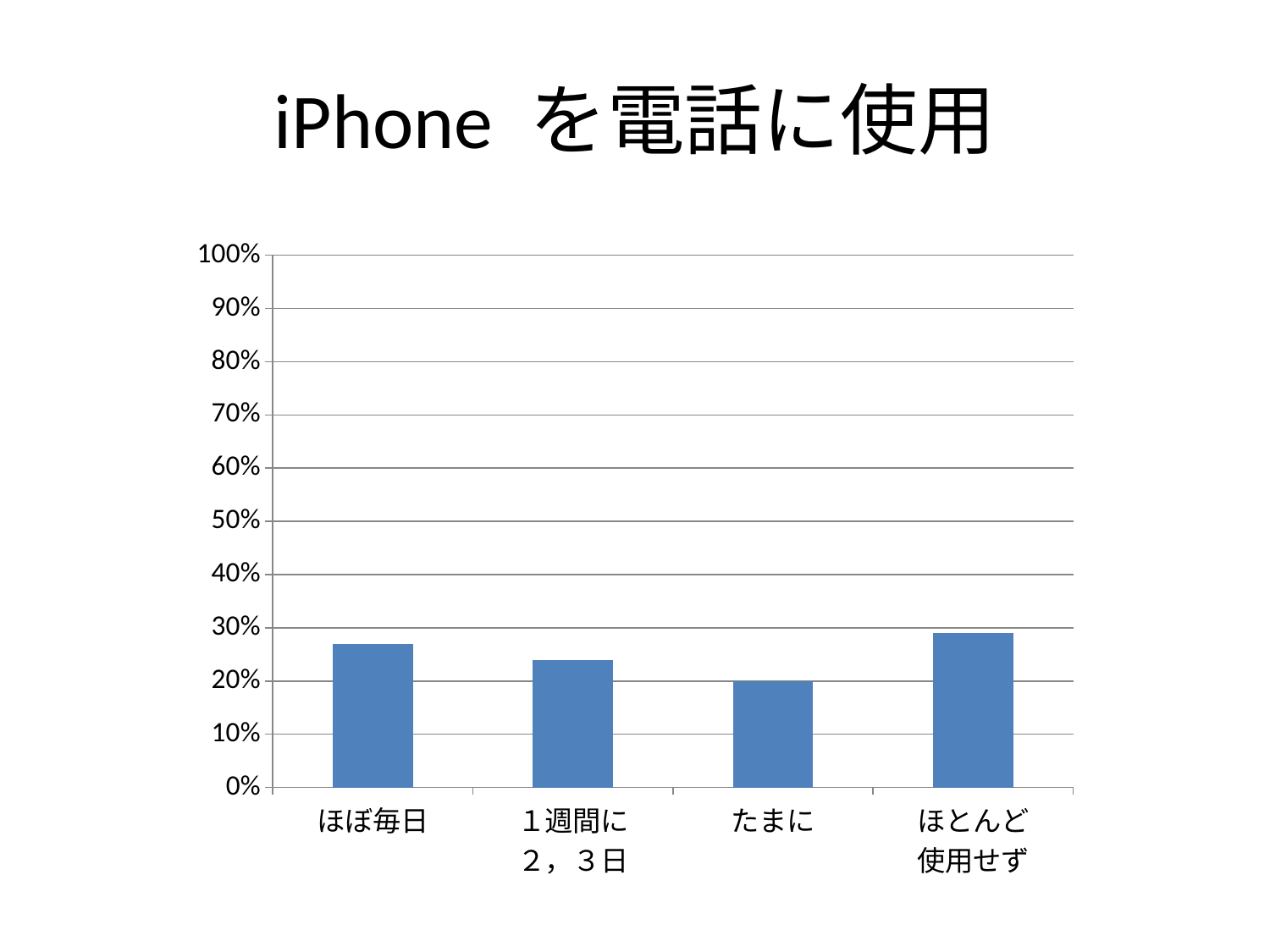
What is the maximum value shown on the y axis? 100% Which category has the lowest value? たまに Is the value for ほぼ毎日 greater or less than 30%? less Is the value for １週間に２，３日 greater or less than 20%? greater What kind of chart is shown on the slide? bar chart Is the value for ほぼ毎日 greater or less than 20%? greater How many categories are shown on the x axis? 4 What is the value for たまに? 20% Which category has the highest value? ほとんど使用せず What is the title of the chart? iPhone を電話に使用 Which is larger, the value for ほぼ毎日 or the value for たまに? ほぼ毎日